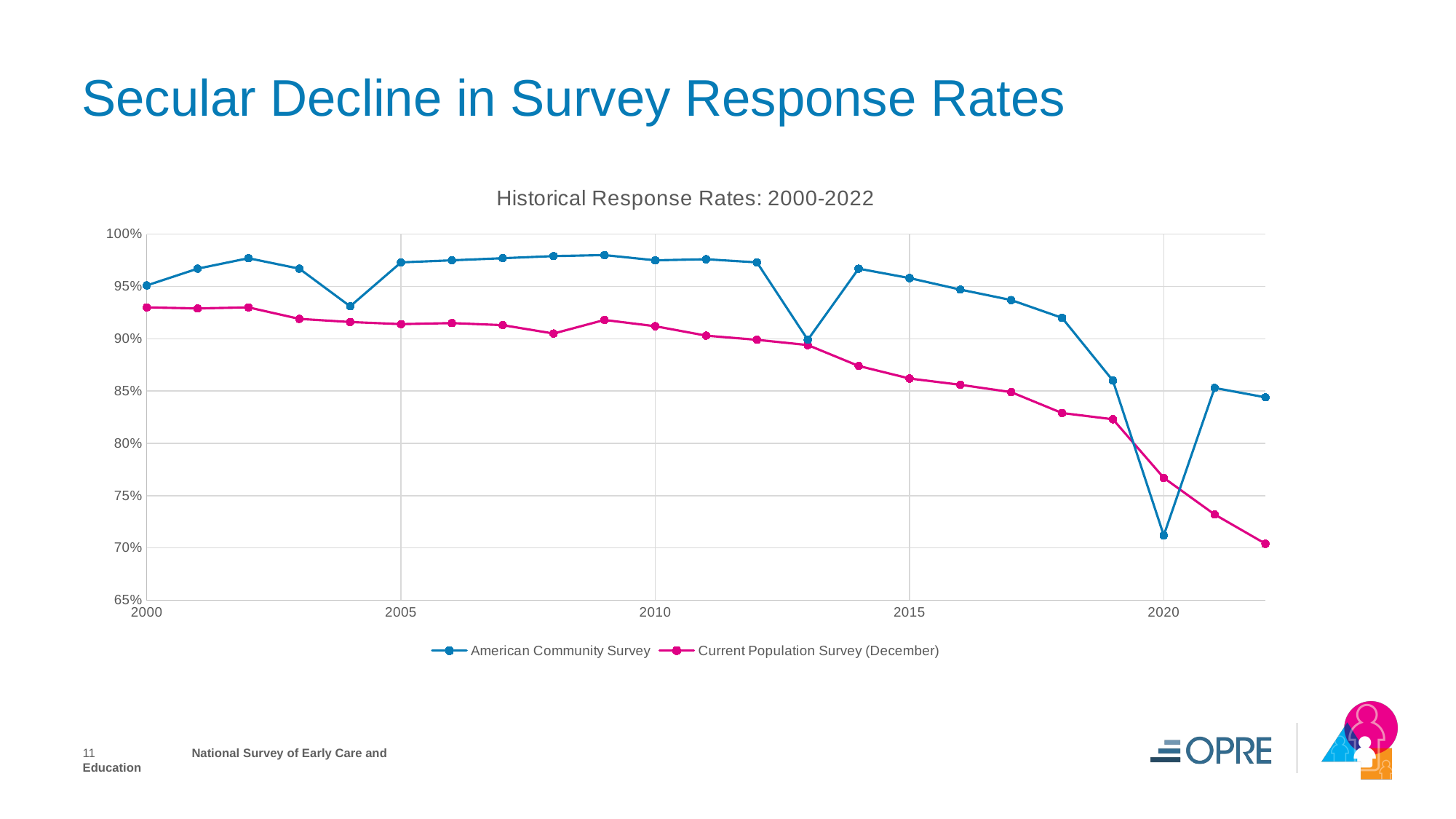
In 2020, which series has the higher response rate? Current Population Survey (December) How many yearly data points does each series have? 23 Which series is drawn in pink/magenta? Current Population Survey (December) In which year is the American Community Survey response rate lowest? 2020 Is the American Community Survey value for 2020 greater or less than 75%? less In 2010, which series has the higher response rate? American Community Survey How many series does the legend list? 2 Is the Current Population Survey (December) value for 2022 greater or less than 75%? less What kind of chart is shown on the slide? line chart Is the Current Population Survey (December) value for 2000 greater or less than 90%? greater What is the title of the chart? Historical Response Rates: 2000-2022